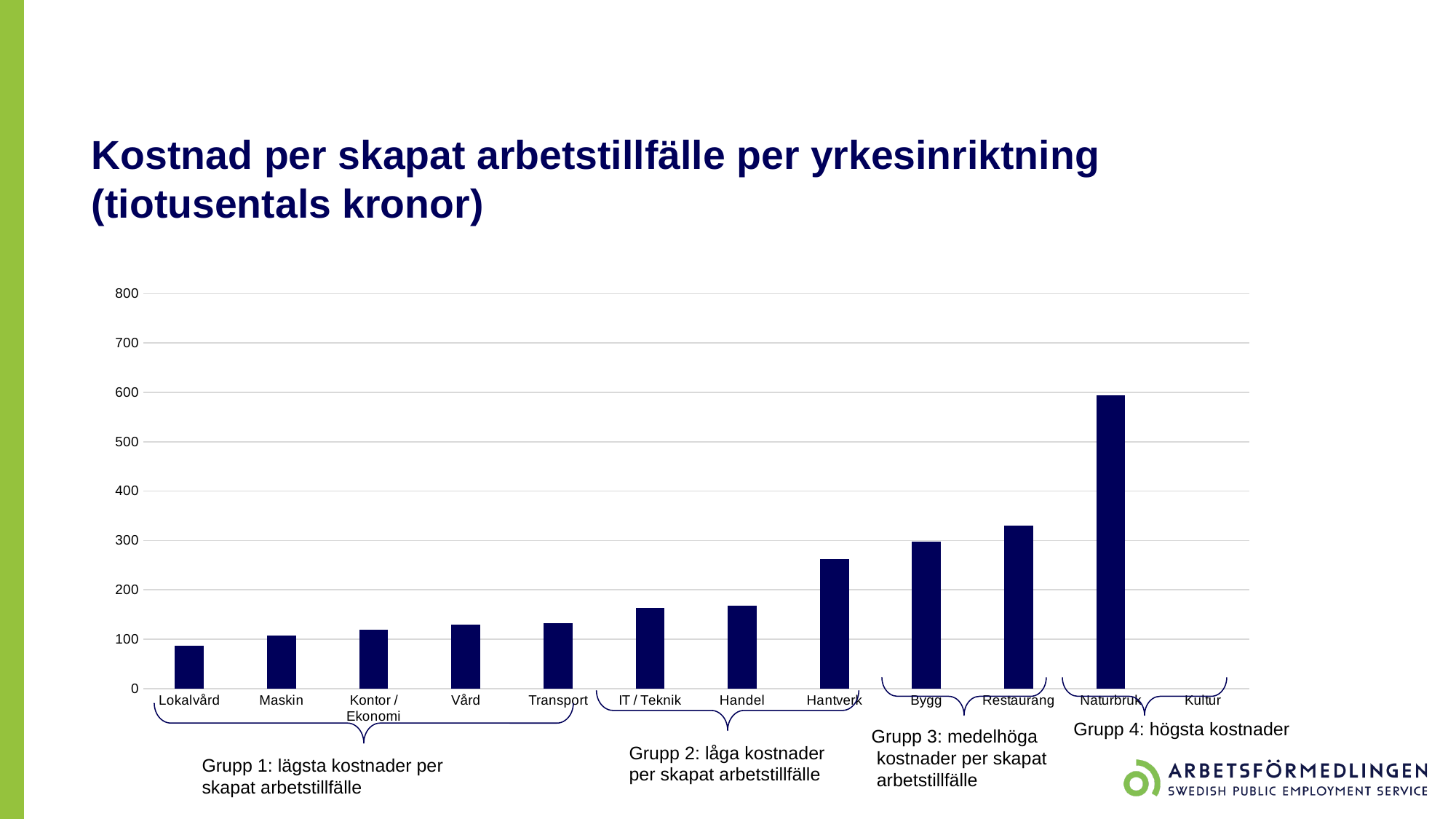
How many groups (Grupp) are annotated beneath the x axis of the chart? 4 Is the value for Naturbruk greater or less than 500? greater Is the value for Lokalvård greater or less than 100? less Which has the larger value, Hantverk or Handel? Hantverk Which category has the tallest bar in the chart? Naturbruk Is the value for Vård greater or less than 100? greater Do the bar values generally rise or fall from Lokalvård to Naturbruk along the x axis? rise Which has the larger value, Bygg or Hantverk? Bygg What kind of chart is shown on the slide? bar chart